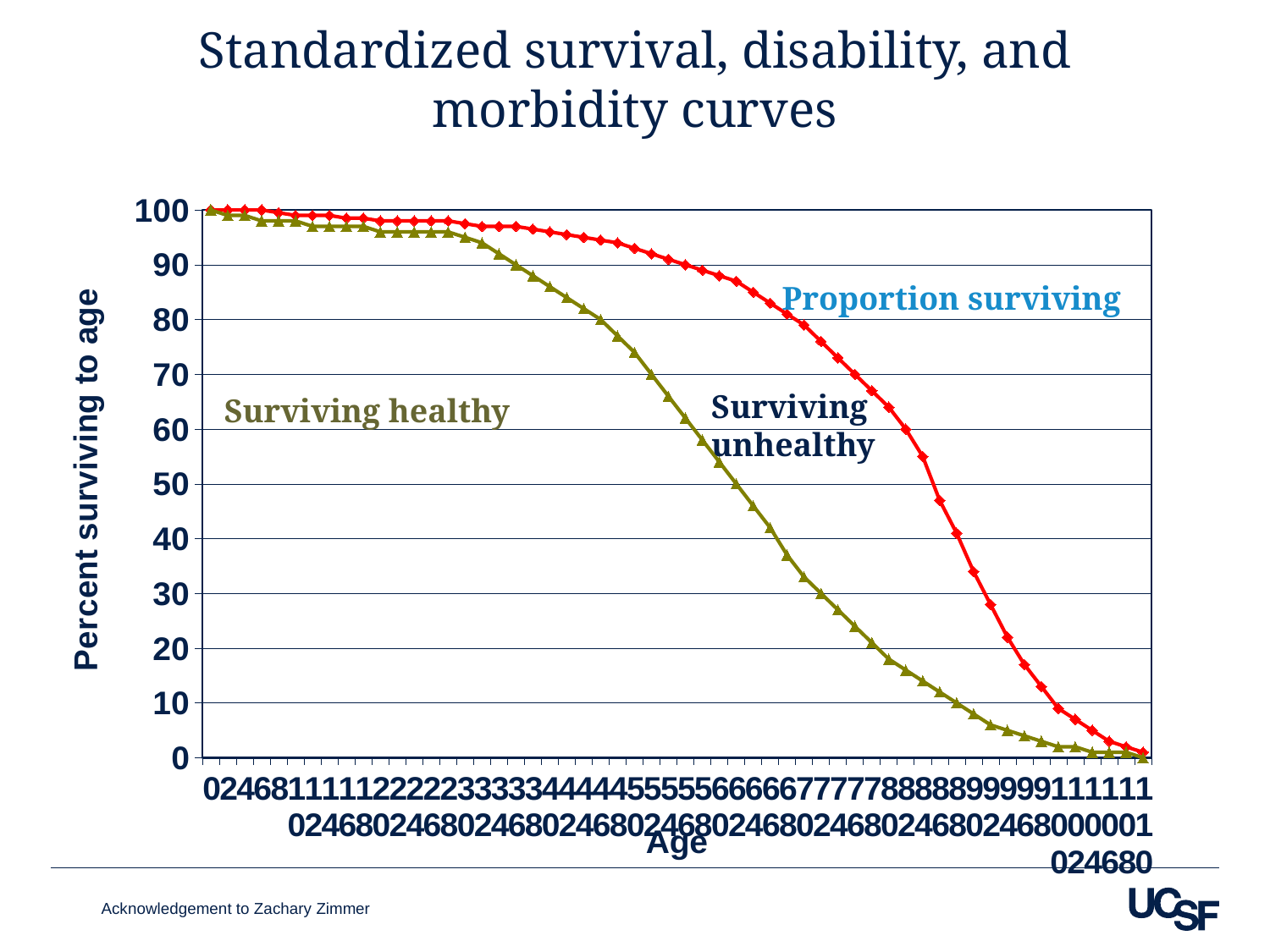
Which curve is higher across the chart, Proportion surviving or Surviving healthy? Proportion surviving How many curves are plotted on the chart? 2 Is the Proportion surviving curve at age 80 greater or less than 50? greater What is the title of the chart on the slide? Standardized survival, disability, and morbidity curves What is the label of the y axis? Percent surviving to age Is the Proportion surviving curve at age 100 greater or less than 20? less What is the value of the Proportion surviving curve at age 0? 100 What kind of chart is shown on the slide? line chart What is the highest value shown on the y axis? 100 Is the Surviving healthy curve at age 40 greater or less than 80? greater Do the curves rise or fall as age increases along the x axis? fall